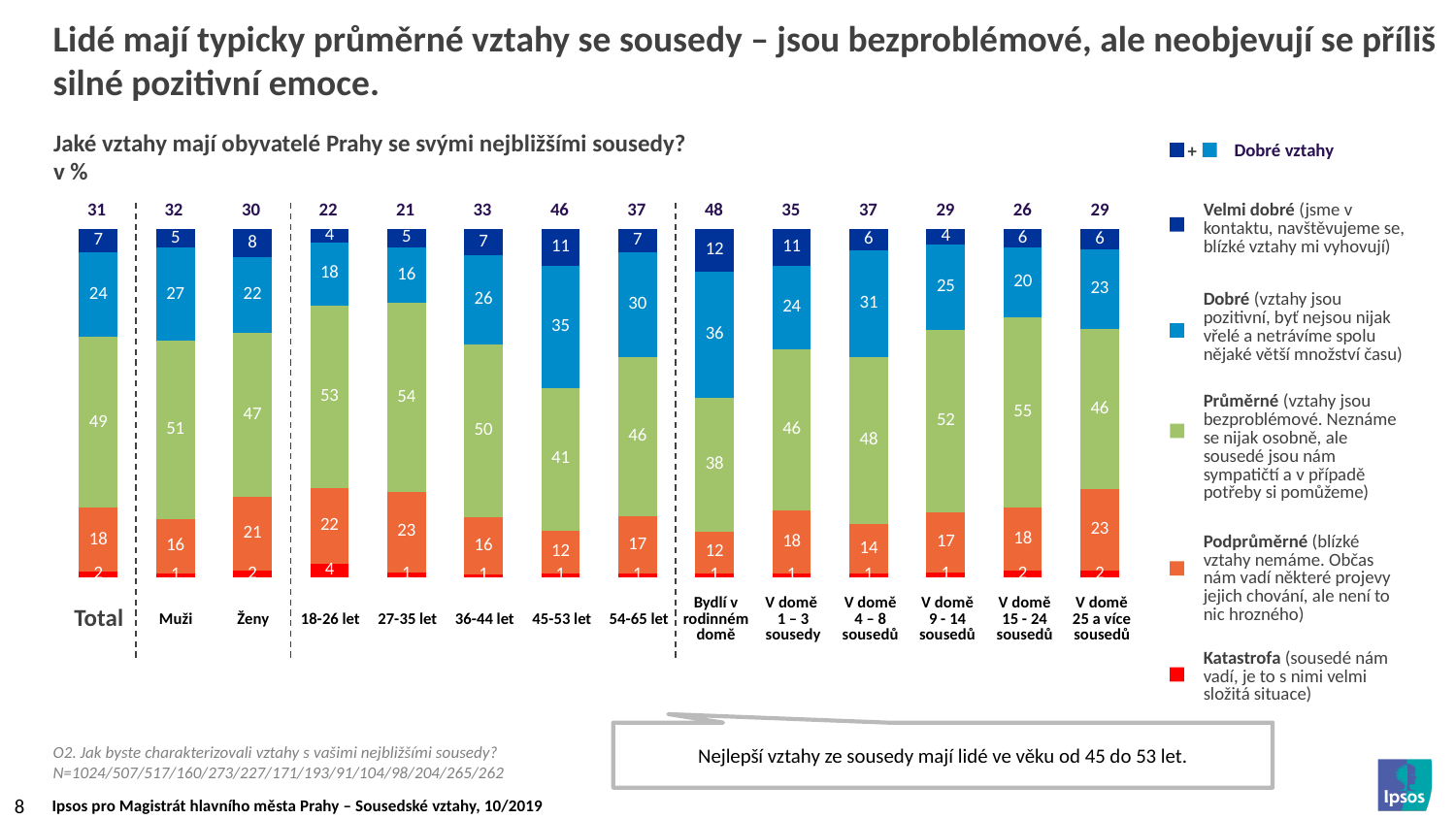
What is the Dobré vztahy figure shown above the bar for 18-26 let? 22 What is the difference between the Podprůměrné values for Ženy and Muži? 5 What is the value of the Velmi dobré segment for the 45-53 let group? 11 Which category has the highest Dobré vztahy figure shown above the bars? Bydlí v rodinném domě Which group has a larger Dobré segment, 54-65 let or 36-44 let? 54-65 let What is the value of the Průměrné segment for the Total bar? 49 Which category has the lowest Dobré vztahy figure shown above the bars? 27-35 let What kind of chart is shown on the slide? Stacked bar chart How many series does the legend list? 5 What colour represents the Katastrofa category in the legend? Red What is the value of the Katastrofa segment for the 18-26 let group? 4 How many categories (bars) are shown in the chart? 14